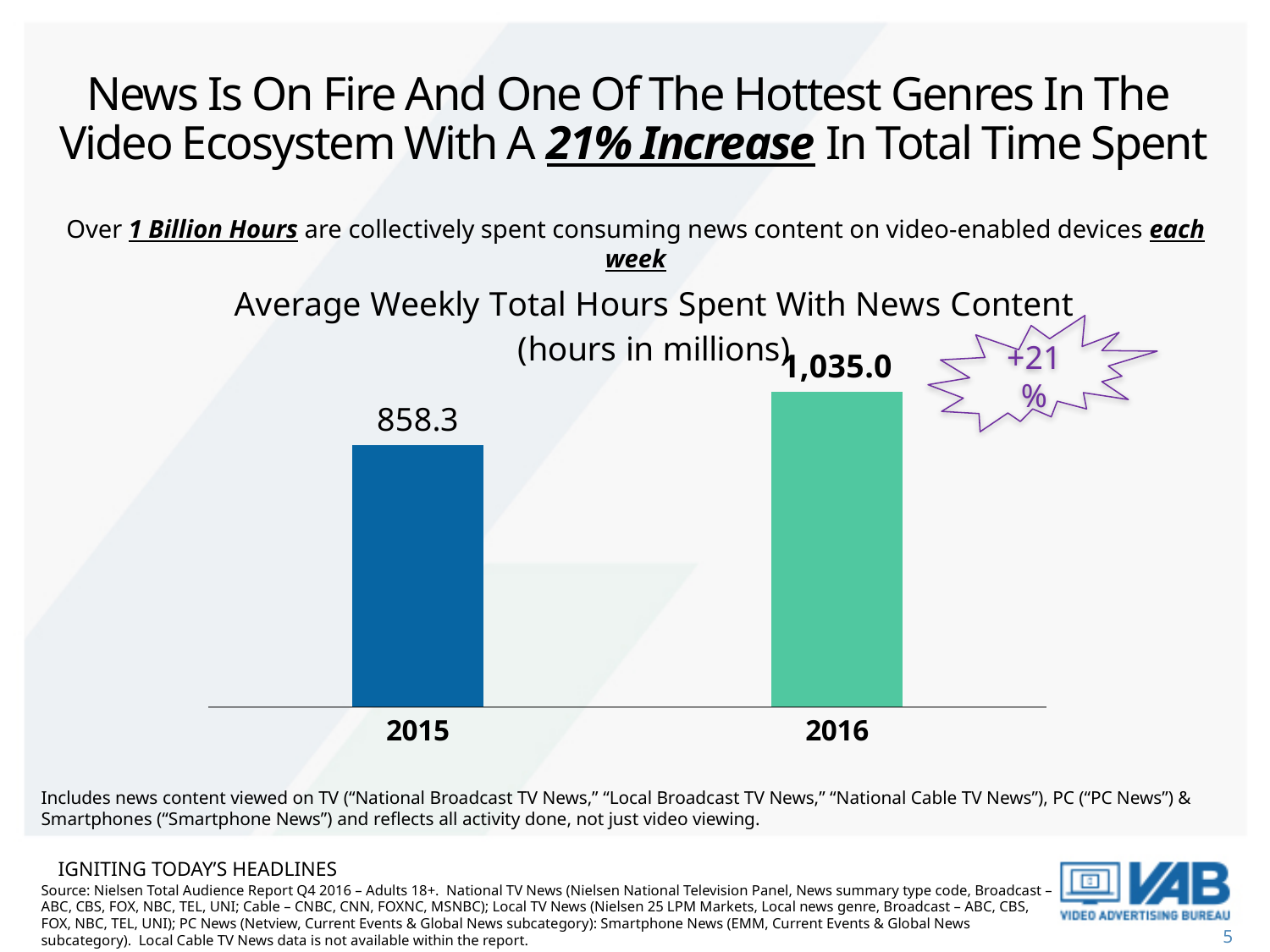
Which year has the higher value? 2016 How many categories are shown on the x axis? 2 Which year has the lower value? 2015 What is the title of the chart? Average Weekly Total Hours Spent With News Content (hours in millions) What kind of chart is shown? Bar chart What percentage change is shown in the callout next to the 2016 bar? +21% What is the value for 2015? 858.3 Do the values rise or fall from 2015 to 2016? Rise Is the value for 2016 larger than the value for 2015? Yes What is the value for 2016? 1,035.0 What is the difference between the 2016 and 2015 values? 176.7